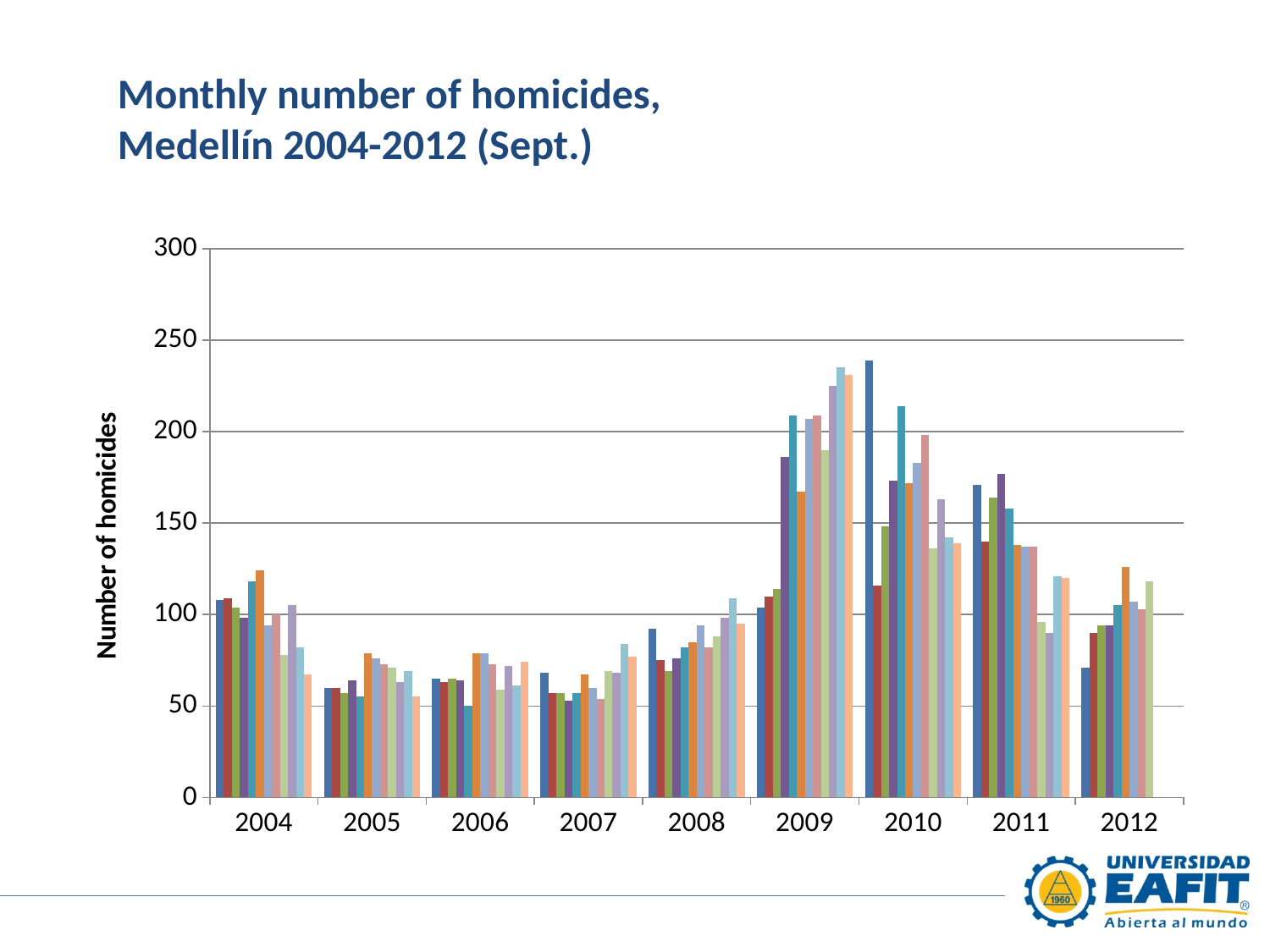
How many year groups are shown along the x axis? 9 What is the title of the chart? Monthly number of homicides, Medellín 2004-2012 (Sept.) Which year group has taller bars overall, 2005 or 2009? 2009 What is the label on the vertical axis of the chart? Number of homicides Is the tallest bar in the 2005 group greater or less than 100? less Is the tallest bar in the 2011 group greater or less than 150? greater How many monthly bars are shown in the 2012 group? 9 What kind of chart is shown on the slide? bar chart Do the monthly homicide bars generally rise or fall from 2006 to 2009? rise Is the tallest bar in the 2009 group greater or less than 200? greater Do the monthly homicide bars generally rise or fall from 2009 to 2012? fall